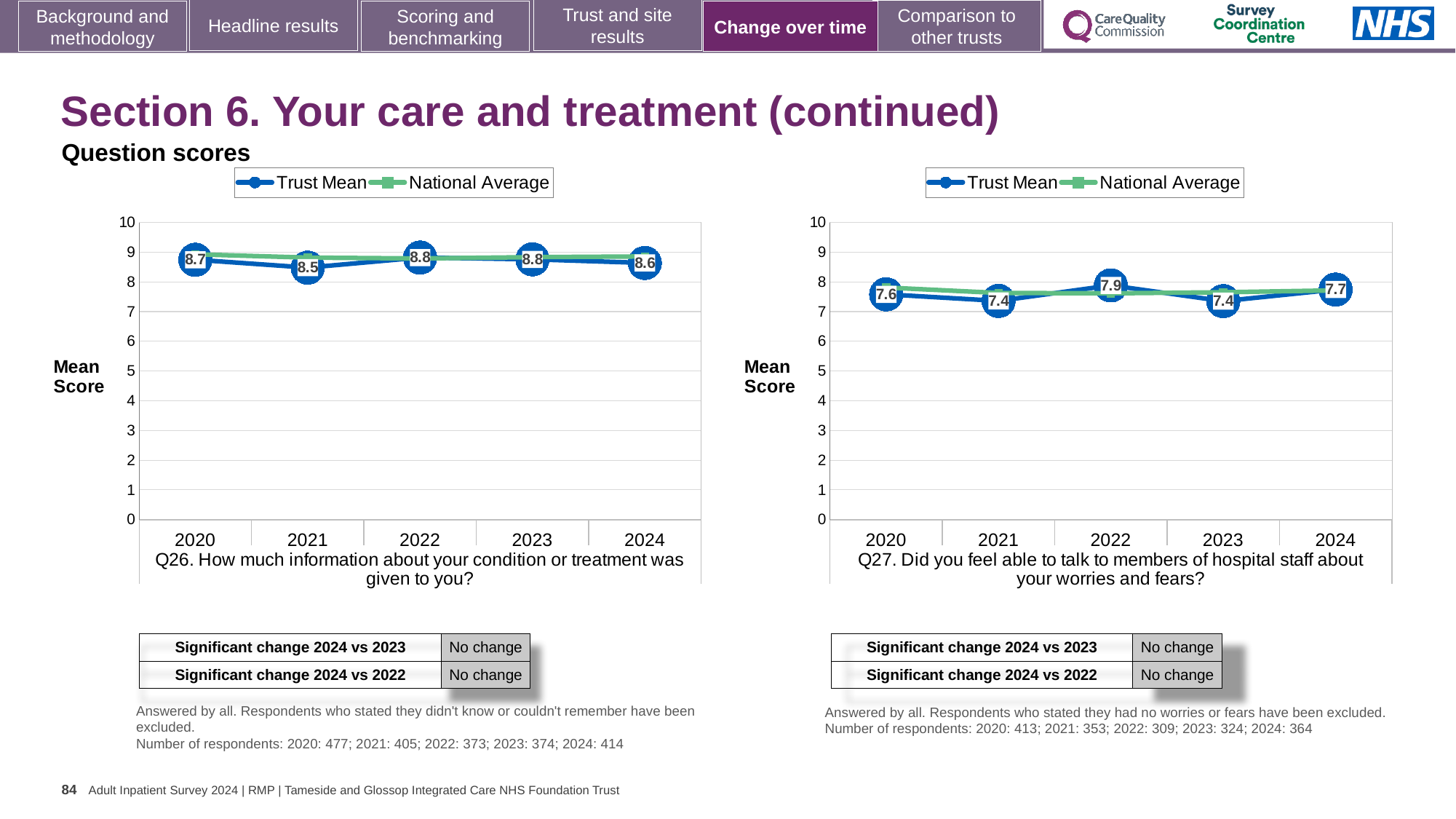
In the Q27 chart (right), which year has the highest Trust Mean score? 2022 What kind of chart is used for Q26 (left)? Line chart How many years are plotted on the x axis of the Q26 chart (left)? 5 In the Q26 chart (left), what is the Trust Mean score for 2022? 8.8 How many series does the legend of the Q27 chart (right) list? 2 In the Q27 chart (right), what is the Trust Mean score for 2020? 7.6 In the Q26 chart (left), is the Trust Mean score higher in 2020 or in 2021? 2020 In the Q26 chart (left), what is the Trust Mean score for 2021? 8.5 In the Q27 chart (right), is the National Average value for 2020 greater or less than 7? greater In the Q27 chart (right), what is the difference between the Trust Mean scores for 2022 and 2023? 0.5 In the Q26 chart (left), which year has the lowest Trust Mean score? 2021 In the Q27 chart (right), what is the Trust Mean score for 2024? 7.7